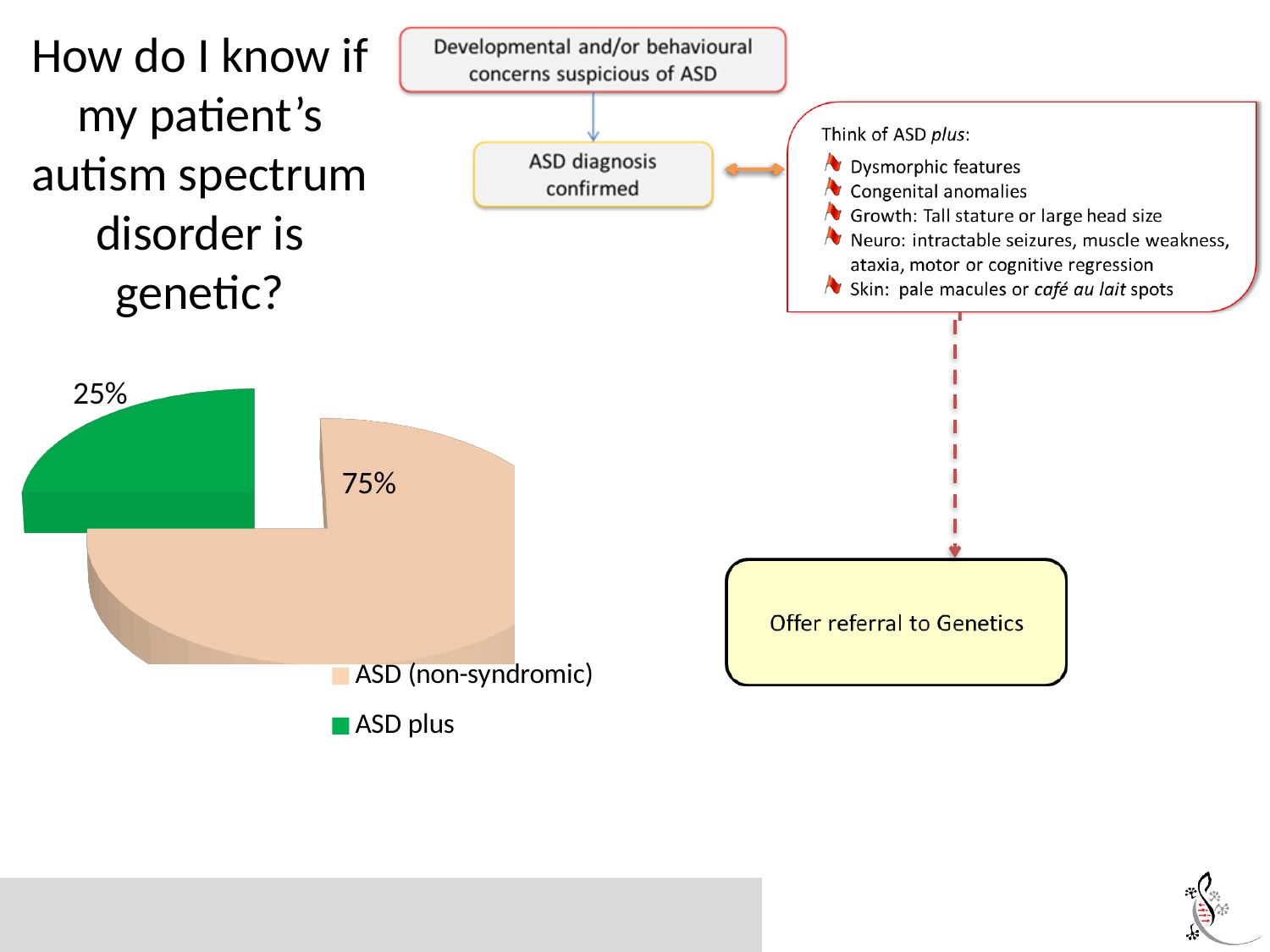
What kind of chart is shown on the slide? pie chart Which is larger, the ASD plus slice or the ASD (non-syndromic) slice? ASD (non-syndromic) What share of the pie is labelled ASD (non-syndromic)? 75% What is the difference in percentage points between the ASD (non-syndromic) slice and the ASD plus slice? 50 How many entries does the pie chart legend list? 2 Which legend entry is shown in a beige/tan colour? ASD (non-syndromic) Which slice of the pie is the largest? ASD (non-syndromic) Which slice of the pie is the smallest? ASD plus What colour is the ASD plus slice in the pie chart? green How many slices does the pie chart have? 2 What share of the pie is labelled ASD plus? 25%